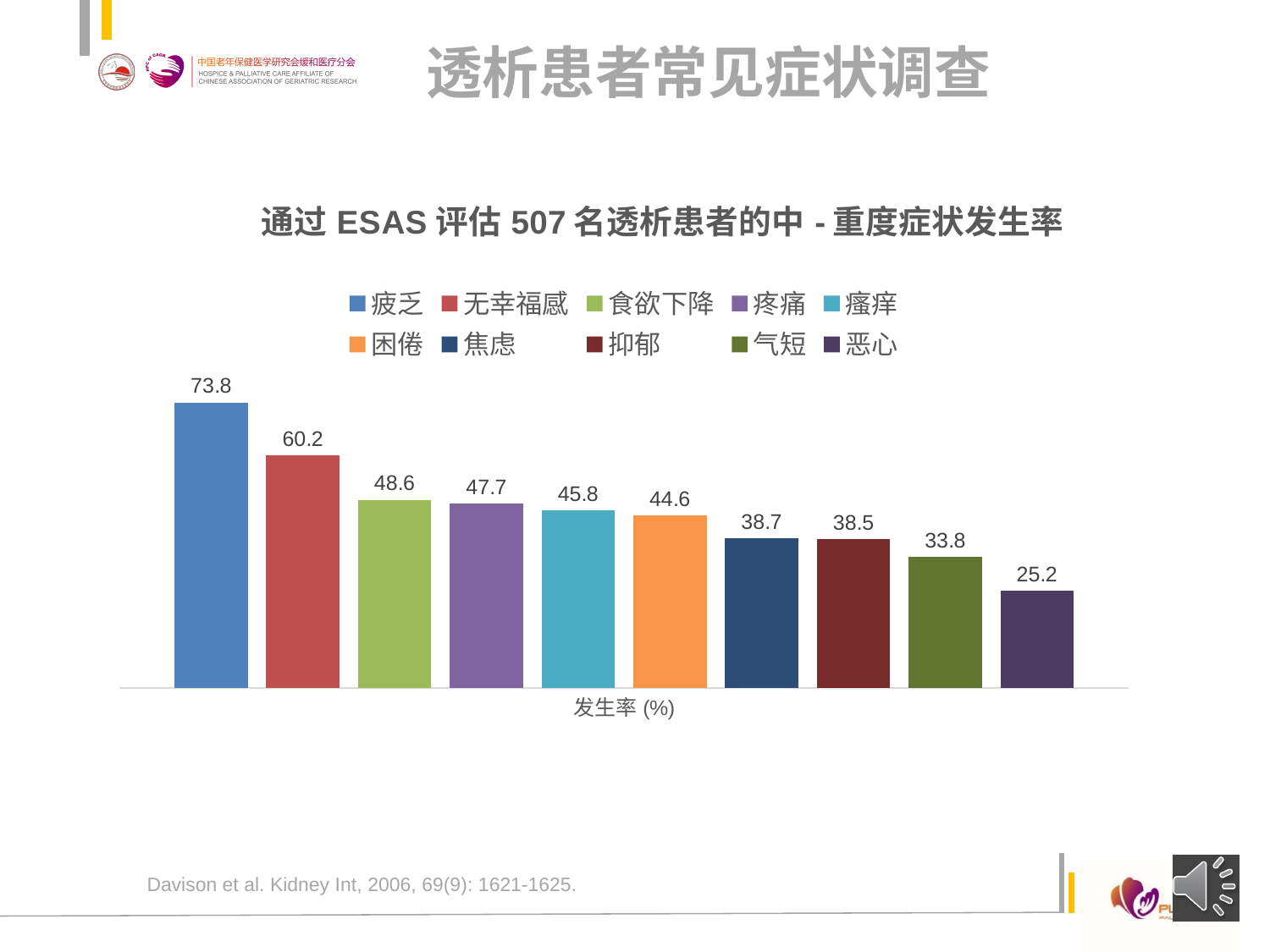
How many bars are plotted in the chart? 10 What is the difference between the values for 食欲下降 and 恶心? 23.4 What is the value for 恶心 (nausea) in the chart? 25.2 Which symptom has the highest value in the chart? 疲乏 What is the value for 疼痛 (pain) in the chart? 47.7 What is the label on the horizontal axis of the chart? 发生率 (%) What is the difference between the values for 疲乏 and 无幸福感? 13.6 What kind of chart is shown on the slide? Bar chart Which is larger, the value for 瘙痒 or the value for 气短? 瘙痒 How many entries does the legend list? 10 What is the value for 疲乏 (fatigue) in the chart? 73.8 Which symptom has the lowest value in the chart? 恶心